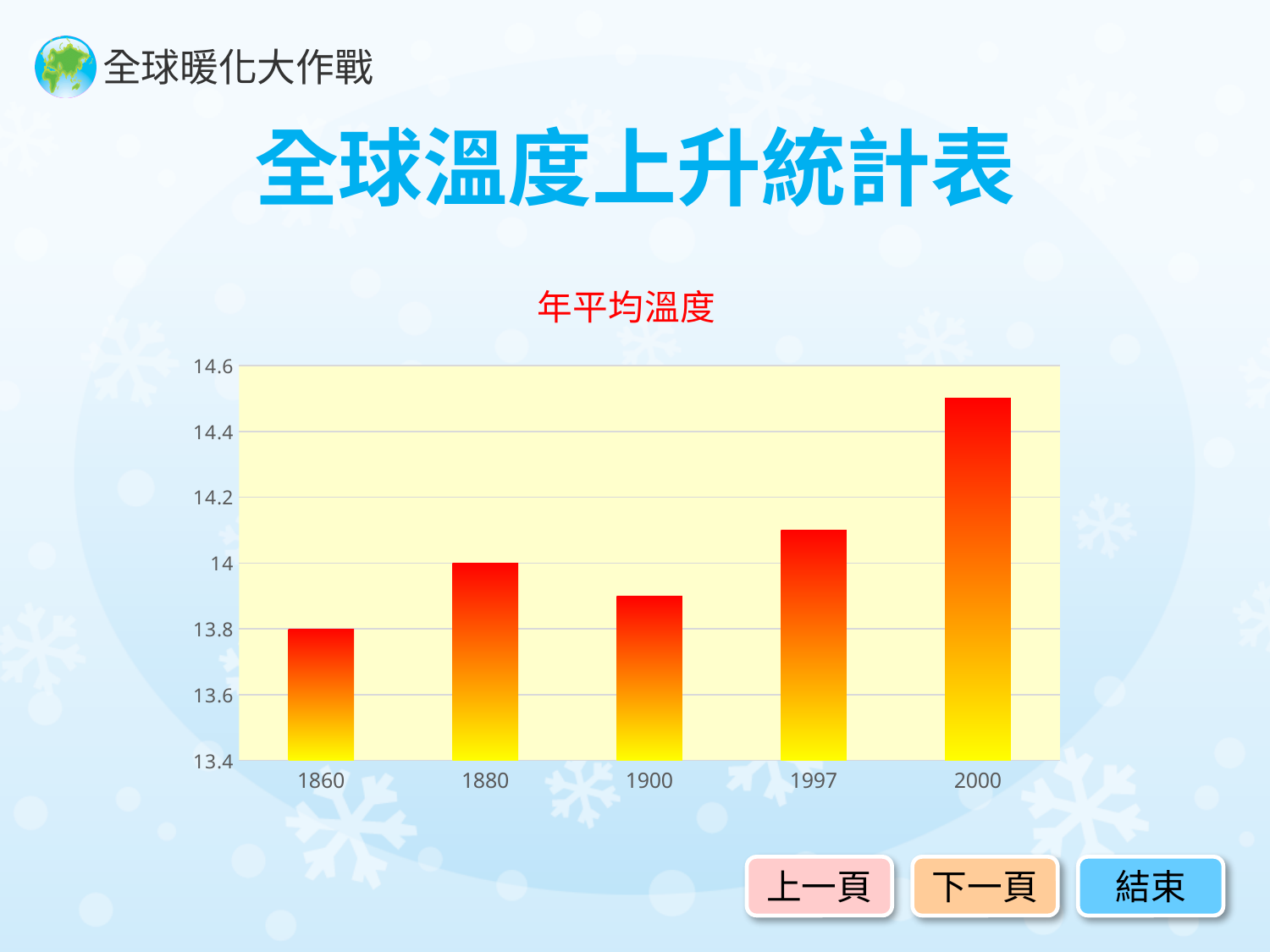
Is the value for 1900 greater or less than 14? less Is the value for 1997 greater or less than 14? greater What kind of chart is shown on the slide? bar chart How many years are shown on the x axis of the chart? 5 What is the title of the chart? 年平均溫度 Which year has the highest value? 2000 What is the value for 1880? 14 Is the value for 2000 greater or less than 14.4? greater Which is larger, the value for 1997 or the value for 1880? 1997 What is the value for 1860? 13.8 Which year has the lowest value? 1860 What is the difference between the values for 1880 and 1860? 0.2